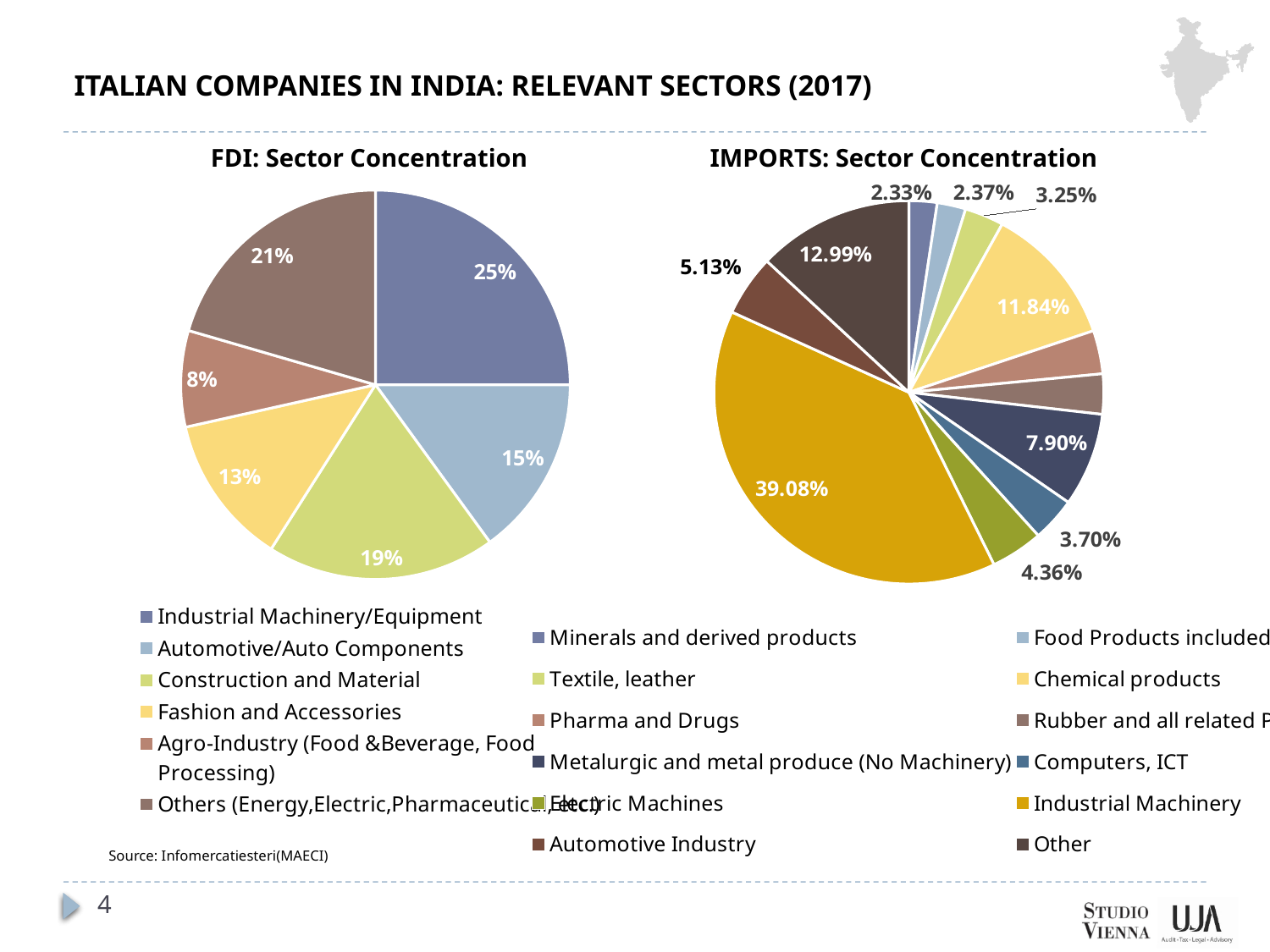
How many entries does the legend of the 'IMPORTS: Sector Concentration' chart list? 12 In the 'FDI: Sector Concentration' chart, what share does Construction and Material have? 19% In the 'IMPORTS: Sector Concentration' chart, what share does Chemical products have? 11.84% In the 'FDI: Sector Concentration' chart, what is the difference in percentage points between Industrial Machinery/Equipment and Agro-Industry? 17 percentage points In the 'FDI: Sector Concentration' chart, which sector has the smallest share? Agro-Industry (Food & Beverage, Food Processing) In the 'FDI: Sector Concentration' chart, which sector has the largest share? Industrial Machinery/Equipment How many slices does the 'FDI: Sector Concentration' pie chart have? 6 In the 'IMPORTS: Sector Concentration' chart, what share does Industrial Machinery have? 39.08% What kind of chart is the 'FDI: Sector Concentration' chart? Pie chart In the 'FDI: Sector Concentration' chart, what share does Industrial Machinery/Equipment have? 25% In the 'IMPORTS: Sector Concentration' chart, which sector has the largest share? Industrial Machinery In the 'FDI: Sector Concentration' chart, which is larger: Automotive/Auto Components or Fashion and Accessories? Automotive/Auto Components